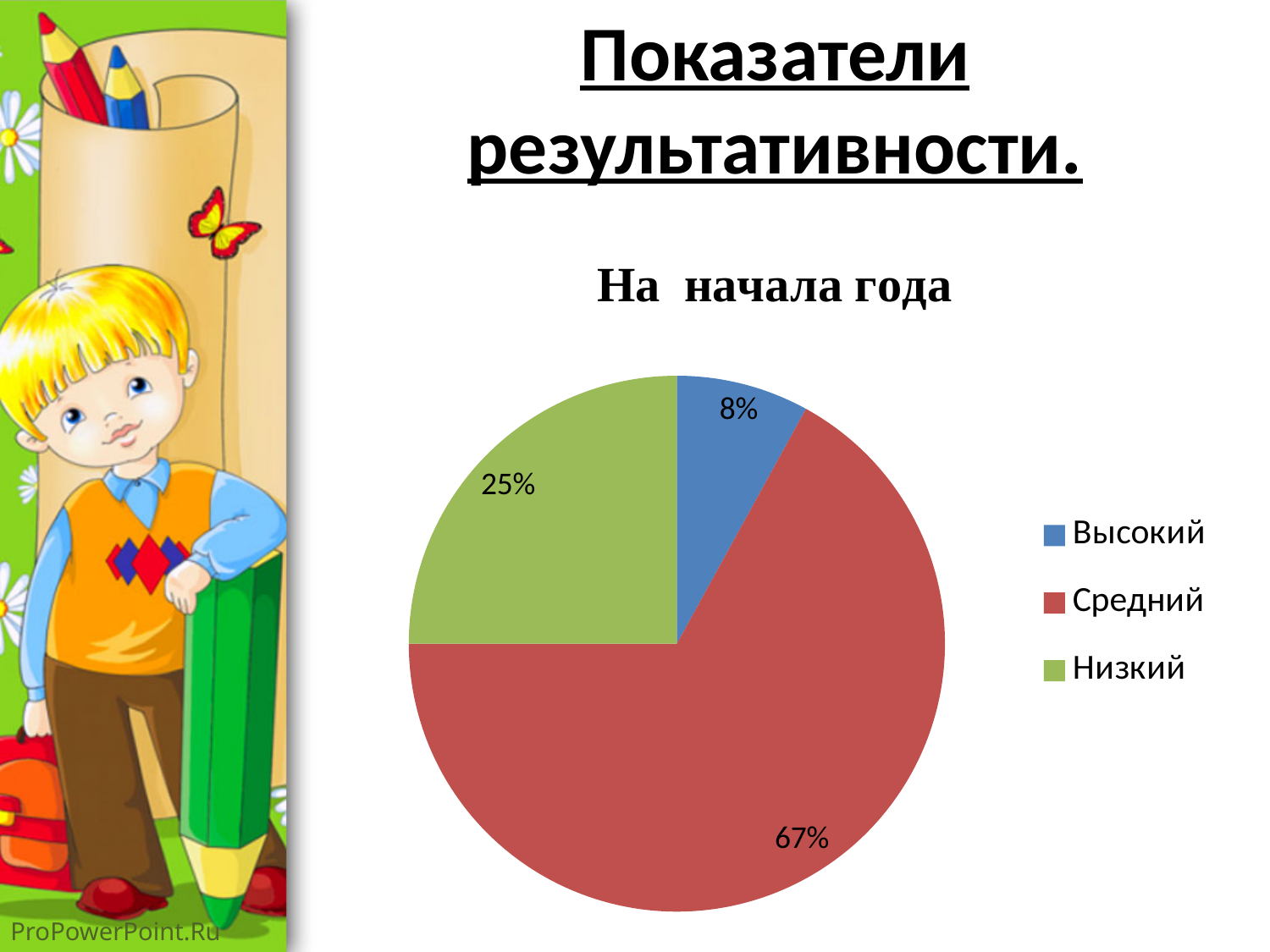
What colour is the slice for Низкий? green What share of the pie does Низкий have? 25% What is the difference in percentage points between Средний and Низкий? 42 Which category has the largest slice of the pie? Средний What share of the pie does Средний have? 67% How many slices does the pie chart have? 3 Which category has the smallest slice of the pie? Высокий What kind of chart is shown on the slide? pie chart What share of the pie does Высокий have? 8% How many entries does the legend list? 3 Which is larger, the share for Низкий or the share for Высокий? Низкий What is the chart's title? На начала года